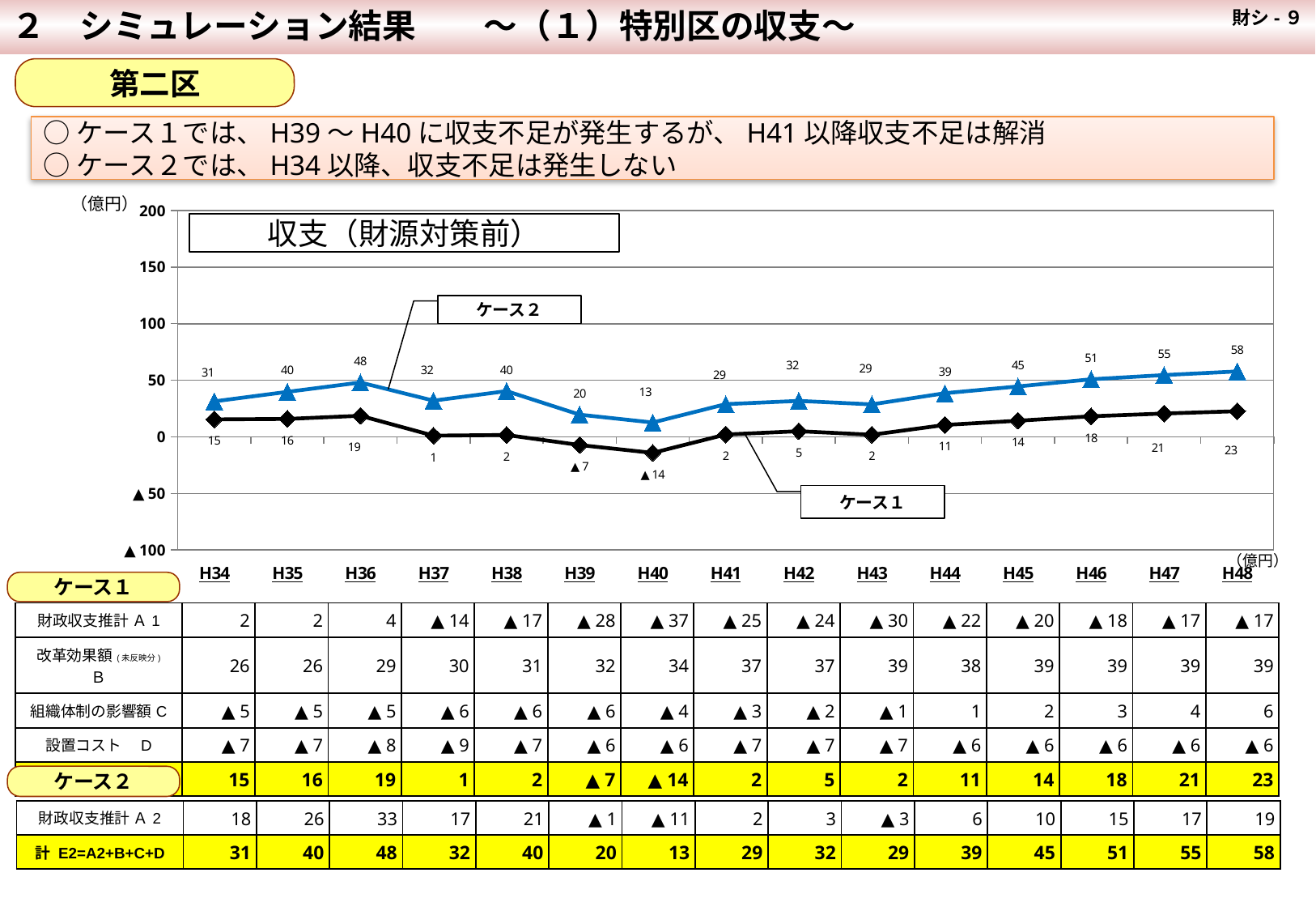
What is the value of ケース2 at H36? 48 What is the difference between ケース2 and ケース1 at H48? 35 In which year does ケース1 reach its lowest value? H40 What is the title shown inside the chart area? 収支（財源対策前） What type of chart is shown on the slide? line chart What is the value of ケース2 at H40? 13 In which year does ケース2 reach its highest value? H48 How many years (data points) are plotted along the x axis of the chart? 15 What is the value of ケース1 at H40? ▲14 How many series are plotted in the chart? 2 Which series has the larger value at H39, ケース1 or ケース2? ケース2 Do the values of ケース2 rise or fall from H41 to H48? rise